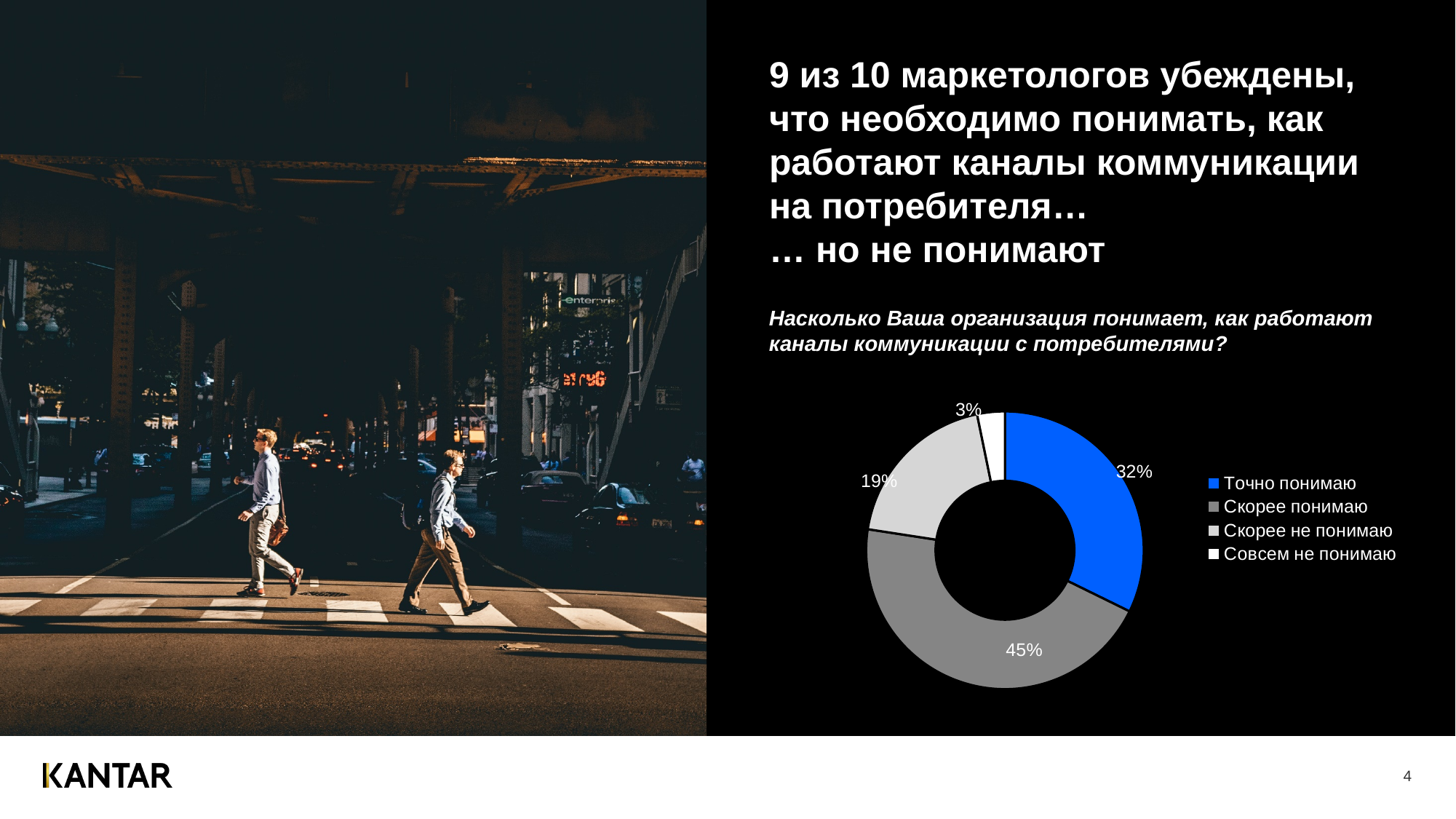
How many slices does the chart have? 4 What share of respondents answered "Совсем не понимаю"? 3% Which colour represents "Точно понимаю" in the chart? Blue Which answer option has the smallest share in the chart? Совсем не понимаю What is the difference in percentage points between "Скорее понимаю" and "Точно понимаю"? 13 Which is larger: the share for "Точно понимаю" or for "Скорее не понимаю"? Точно понимаю What share of respondents answered "Скорее понимаю"? 45% How many entries does the chart legend list? 4 Which answer option has the largest share in the chart? Скорее понимаю What kind of chart is shown on the slide? Doughnut (pie) chart What share of respondents answered "Точно понимаю"? 32% What share of respondents answered "Скорее не понимаю"? 19%